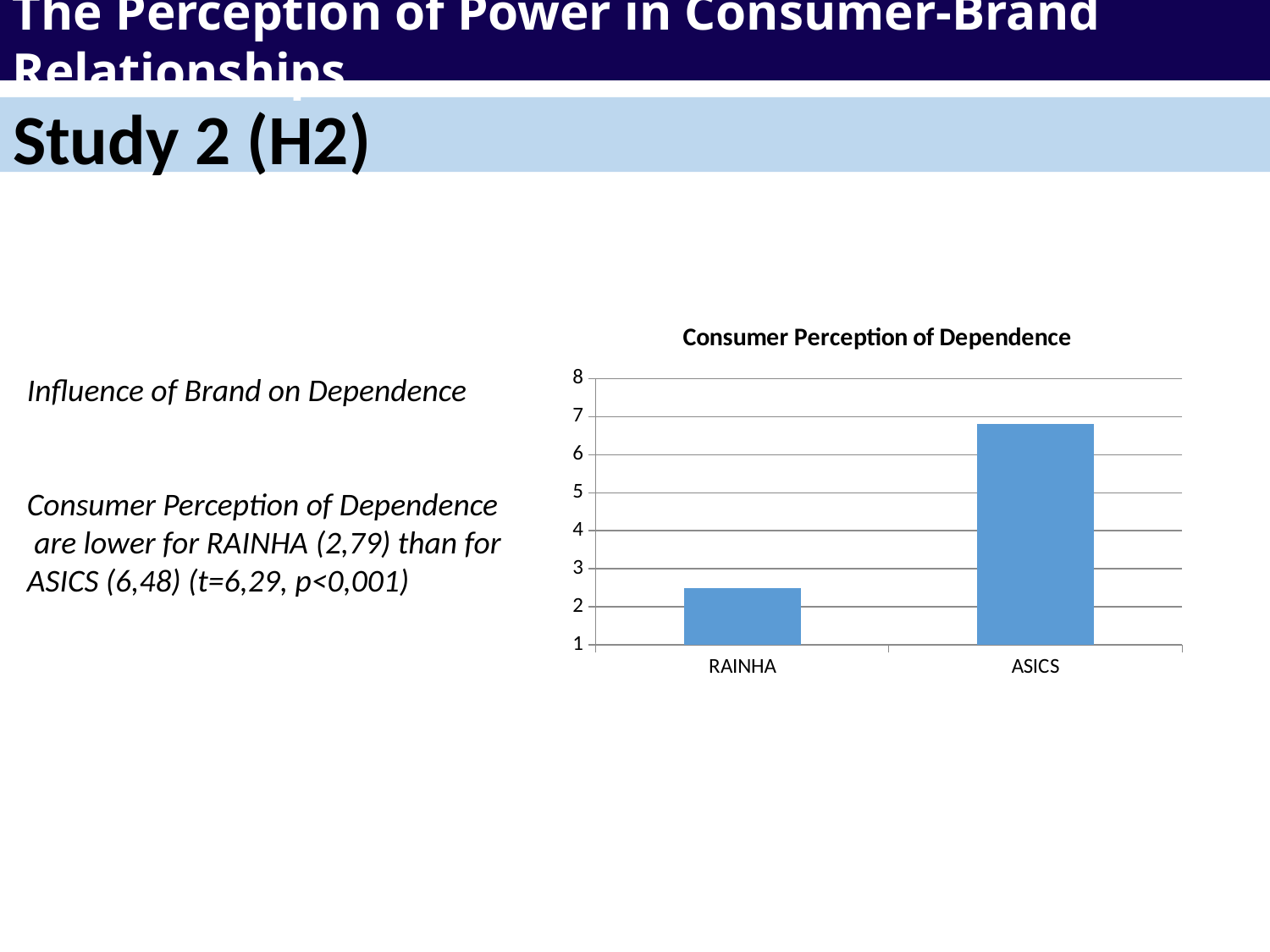
How many categories are shown on the x axis of the chart? 2 Which category has the lowest bar in the chart? RAINHA What type of chart is shown on the slide? bar chart Which category has the highest bar in the chart? ASICS Do the bar values rise or fall from RAINHA to ASICS along the x axis? rise Is the value for RAINHA greater or less than 2? greater Is the value for ASICS greater or less than 7? less What is the title of the chart? Consumer Perception of Dependence Is the value for RAINHA greater or less than 3? less Which bar is taller, RAINHA or ASICS? ASICS What is the maximum value shown on the y axis of the chart? 8